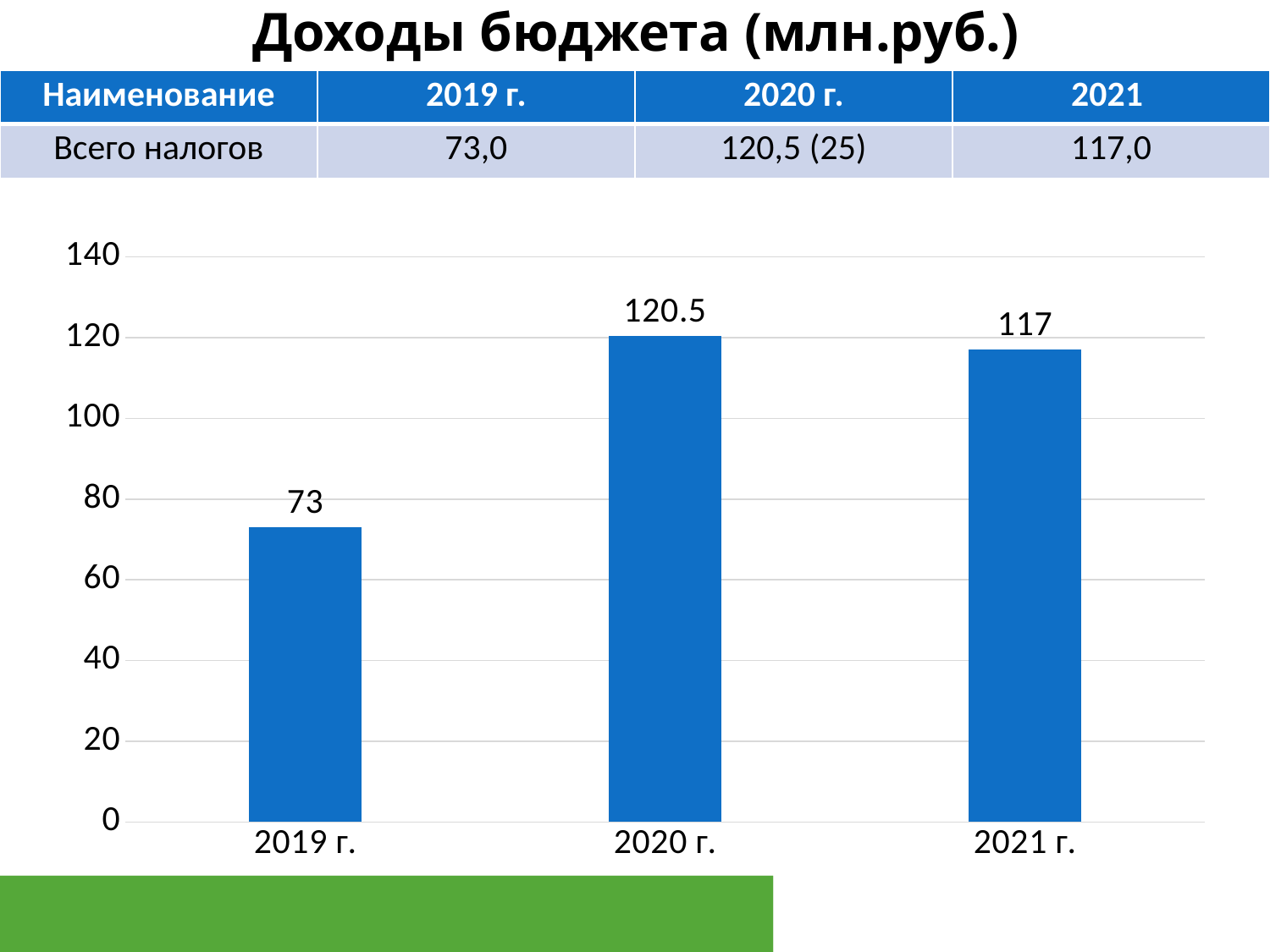
What is the title of the slide above the chart? Доходы бюджета (млн.руб.) What is the value for 2021 г.? 117 How many bars are in the chart? 3 Which is larger, the value for 2021 г. or the value for 2019 г.? 2021 г. What is the difference between the values for 2020 г. and 2019 г.? 47.5 Which year has the lowest value? 2019 г. Which year has the highest value? 2020 г. Is the value for 2019 г. greater or less than 80? less What kind of chart is shown on the slide? bar chart What is the value for 2019 г.? 73 What is the difference between the values for 2020 г. and 2021 г.? 3.5 What is the value for 2020 г.? 120.5